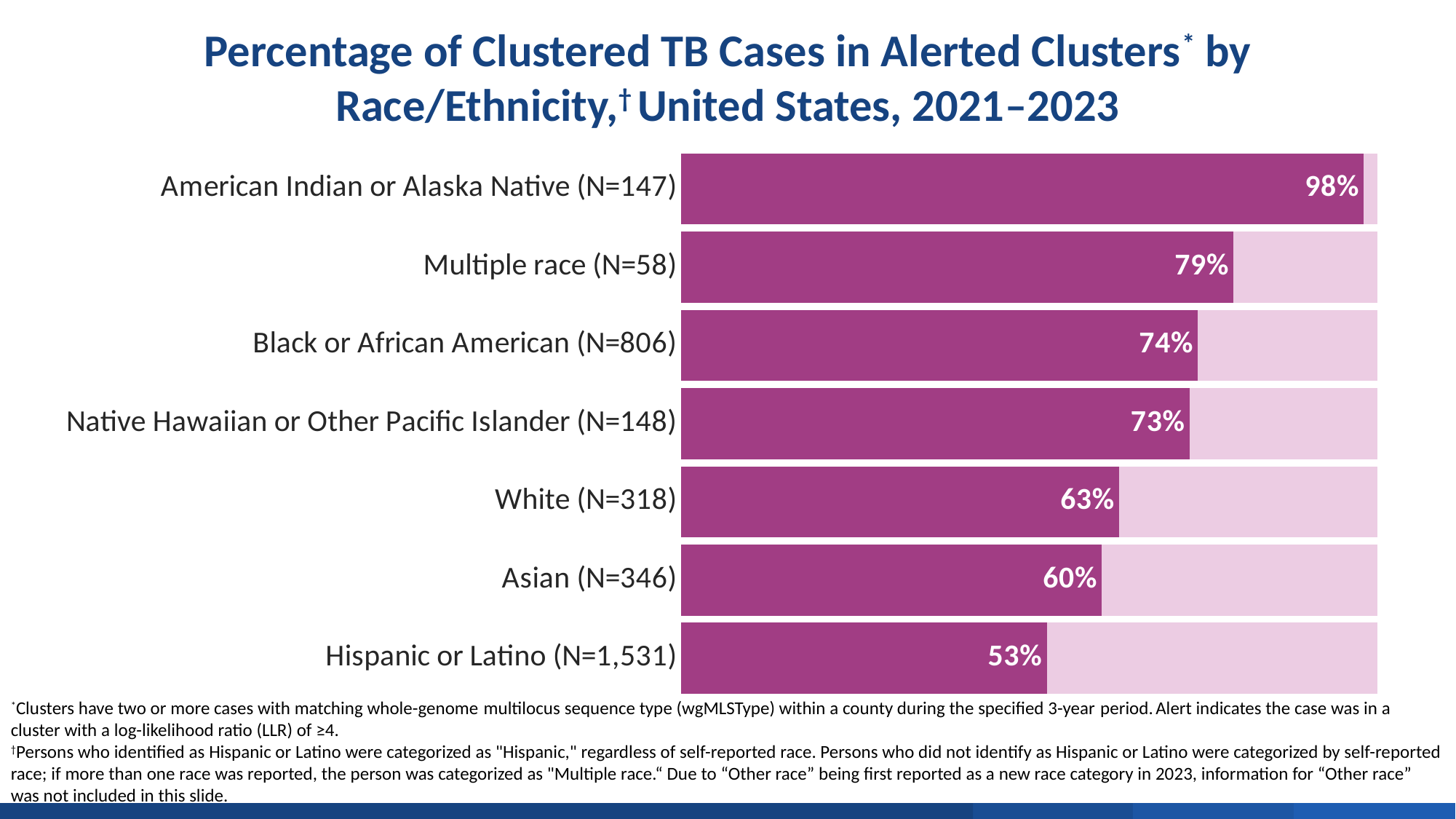
What is the value shown for White (N=318)? 63% What type of chart is shown on the slide? Bar chart What percentage of clustered TB cases were in alerted clusters for Hispanic or Latino persons? 53% Which race/ethnicity category has the lowest percentage of clustered TB cases in alerted clusters? Hispanic or Latino Which race/ethnicity category has the highest percentage of clustered TB cases in alerted clusters? American Indian or Alaska Native What percentage of clustered TB cases were in alerted clusters for American Indian or Alaska Native persons? 98% What is the difference in percentage points between American Indian or Alaska Native and Hispanic or Latino? 45 What is the difference in percentage points between Multiple race and Black or African American? 5 How many race/ethnicity categories are shown in the chart? 7 What is the value shown for Asian (N=346)? 60% What is the N value shown for the Black or African American category? 806 Which has a higher percentage, White or Asian? White